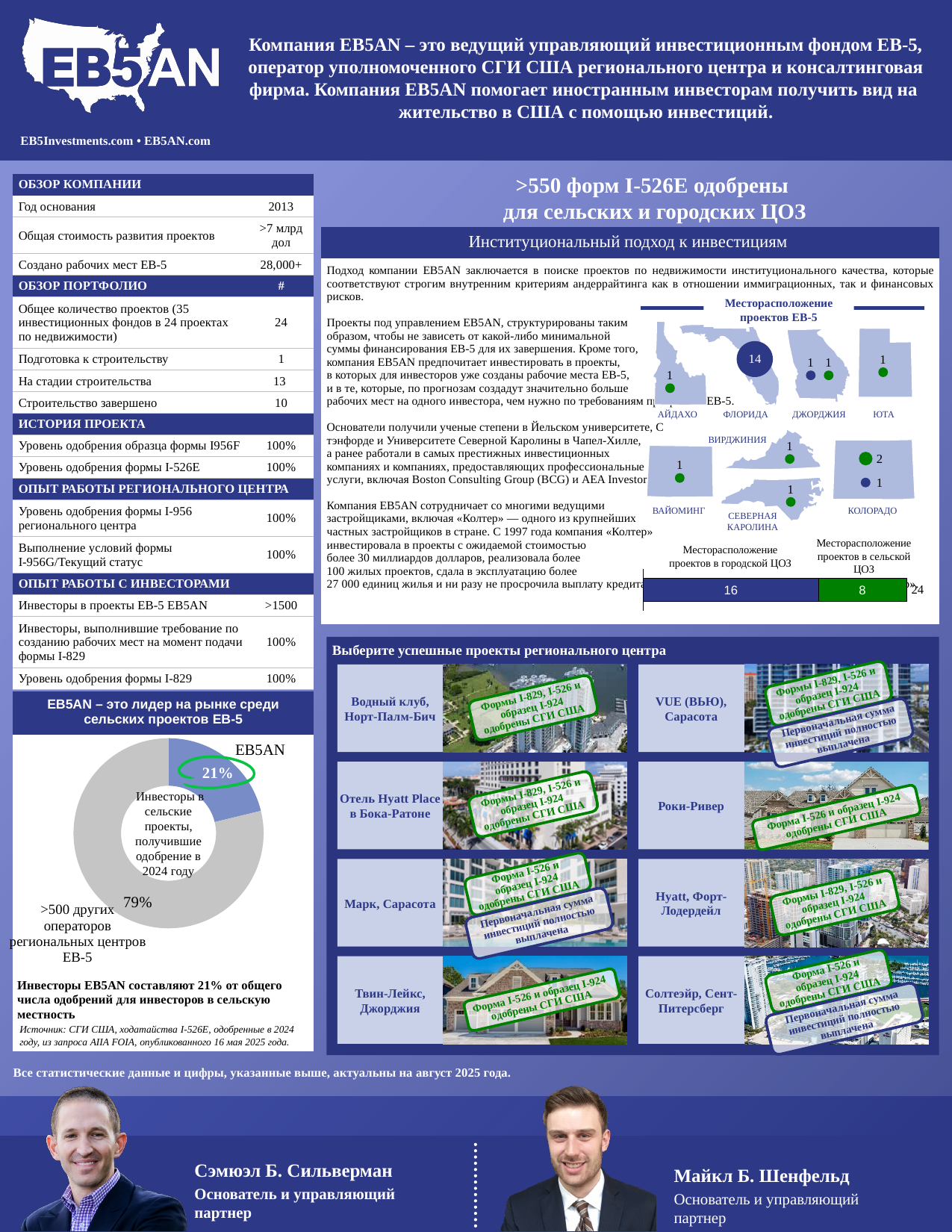
In the donut chart titled 'EB5AN – это лидер на рынке среди сельских проектов EB-5', what share is labelled for EB5AN? 21% In the donut chart titled 'EB5AN – это лидер на рынке среди сельских проектов EB-5', what is the difference in percentage points between the two segments? 58 In the stacked bar chart on the right side of the slide, which segment is larger: urban (городской ЦОЗ) or rural (сельской ЦОЗ)? Городской ЦОЗ In the stacked bar chart on the right side of the slide, what is the difference between the urban and rural project counts? 8 In the stacked bar chart on the right side of the slide, what is the total of the two segments? 24 In the stacked bar chart on the right side of the slide, what is the value for 'Месторасположение проектов в сельской ЦОЗ'? 8 In the donut chart titled 'EB5AN – это лидер на рынке среди сельских проектов EB-5', which segment is larger: EB5AN or the other regional center operators? >500 других операторов региональных центров EB-5 In the stacked bar chart on the right side of the slide, what is the value for 'Месторасположение проектов в городской ЦОЗ'? 16 How many segments does the donut chart titled 'EB5AN – это лидер на рынке среди сельских проектов EB-5' have? 2 What type of chart shows the urban versus rural project locations on the right side of the slide? Stacked bar chart What type of chart is shown under the heading 'EB5AN – это лидер на рынке среди сельских проектов EB-5'? Pie (donut) chart In the donut chart titled 'EB5AN – это лидер на рынке среди сельских проектов EB-5', what share is labelled for '>500 других операторов региональных центров EB-5'? 79%